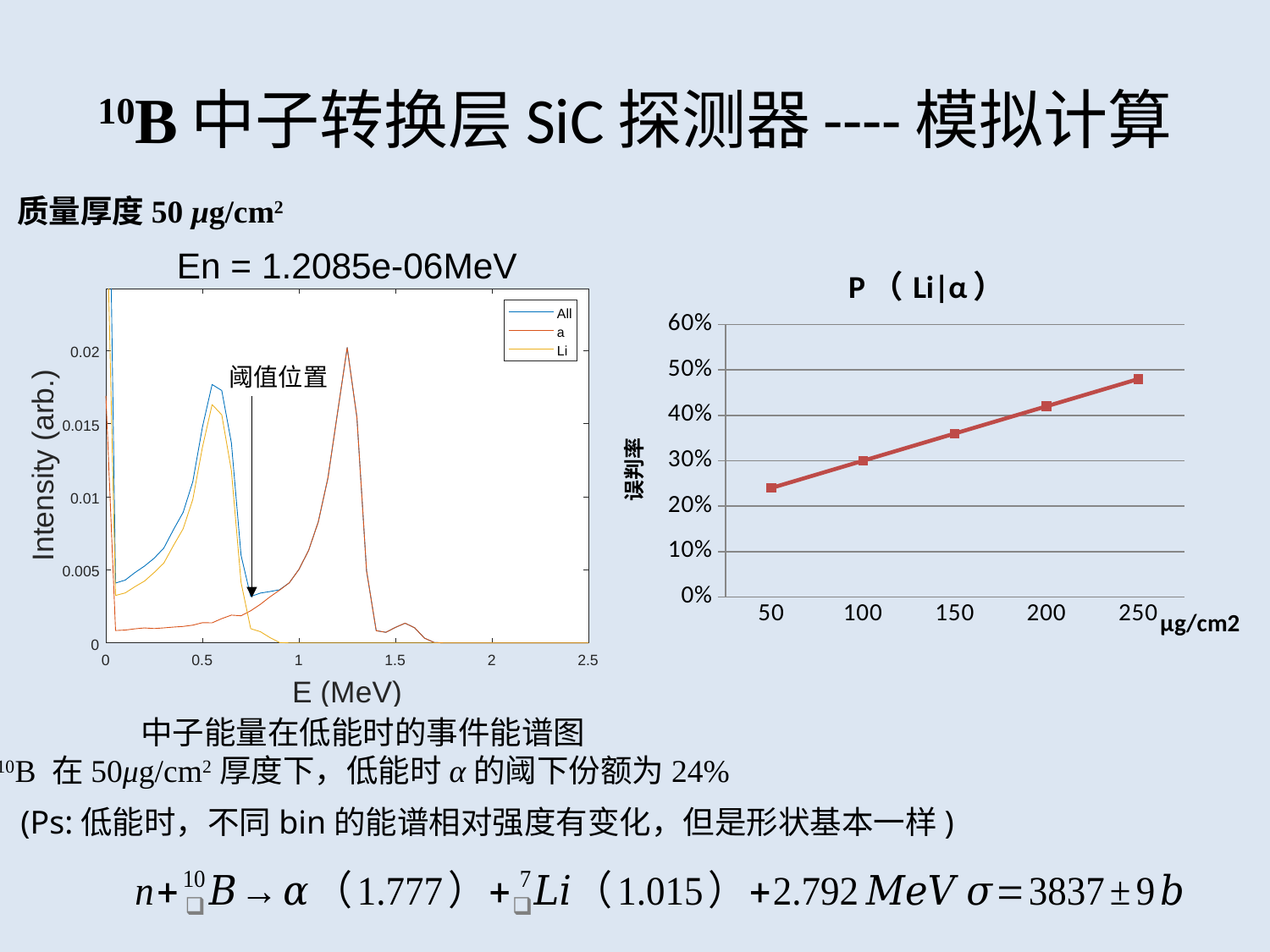
In the chart on the left titled En = 1.2085e-06MeV, what kind of chart is it? line chart In the chart titled P（Li|α）, which mass thickness has the highest value? 250 In the chart titled P（Li|α）, which mass thickness has the lowest value? 50 In the chart on the left titled En = 1.2085e-06MeV, which series has its peak at the higher energy, a or Li? a In the chart titled P（Li|α）, is the value at 150 μg/cm2 greater or less than 40%? less In the chart titled P（Li|α）, is the value at 250 μg/cm2 greater or less than 40%? greater In the chart titled P（Li|α）, do the values rise or fall as the mass thickness increases from 50 to 250 μg/cm2? rise In the chart titled P（Li|α）, how many data points are plotted? 5 In the chart titled P（Li|α）, is the value at 50 μg/cm2 greater or less than 30%? less In the chart titled P（Li|α）, what is the label on the y axis? 误判率 In the chart on the left titled En = 1.2085e-06MeV, how many series does the legend list? 3